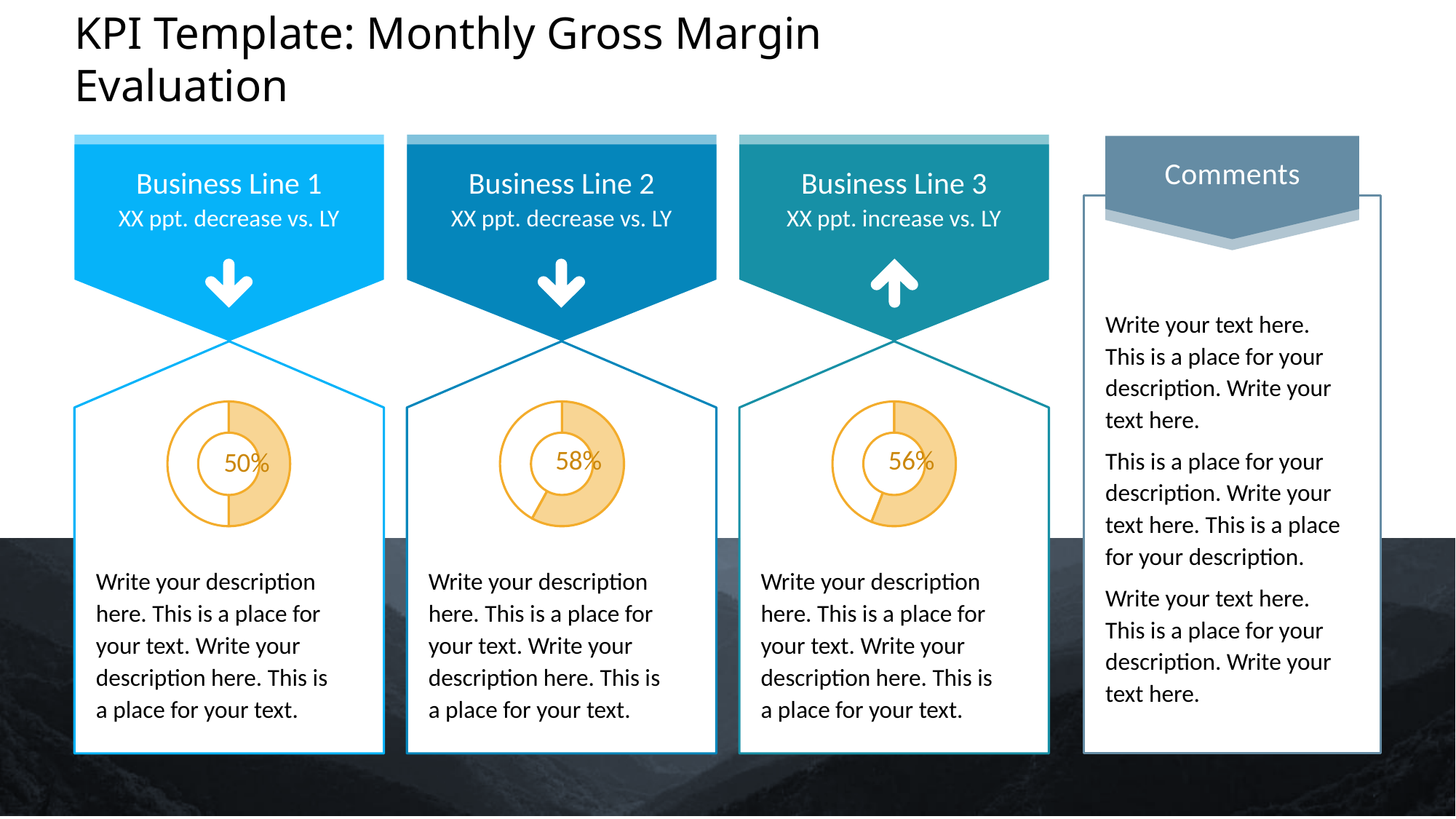
Which business line's donut chart shows the highest percentage? Business Line 2 Which business line shows an increase vs. last year, as indicated by the arrow? Business Line 3 How many donut charts are shown on the slide? 3 What colour is the filled portion of the donut charts? Orange What value is shown in the donut chart for Business Line 1? 50% What value is shown in the donut chart for Business Line 2? 58% What is the difference between the percentages shown for Business Line 2 and Business Line 1? 8% What value is shown in the donut chart for Business Line 3? 56% What is the difference between the percentages shown for Business Line 2 and Business Line 3? 2% Which is larger, the percentage for Business Line 3 or the percentage for Business Line 1? Business Line 3 Which business line's donut chart shows the lowest percentage? Business Line 1 What kind of chart is used to display the percentage for each business line? Donut chart